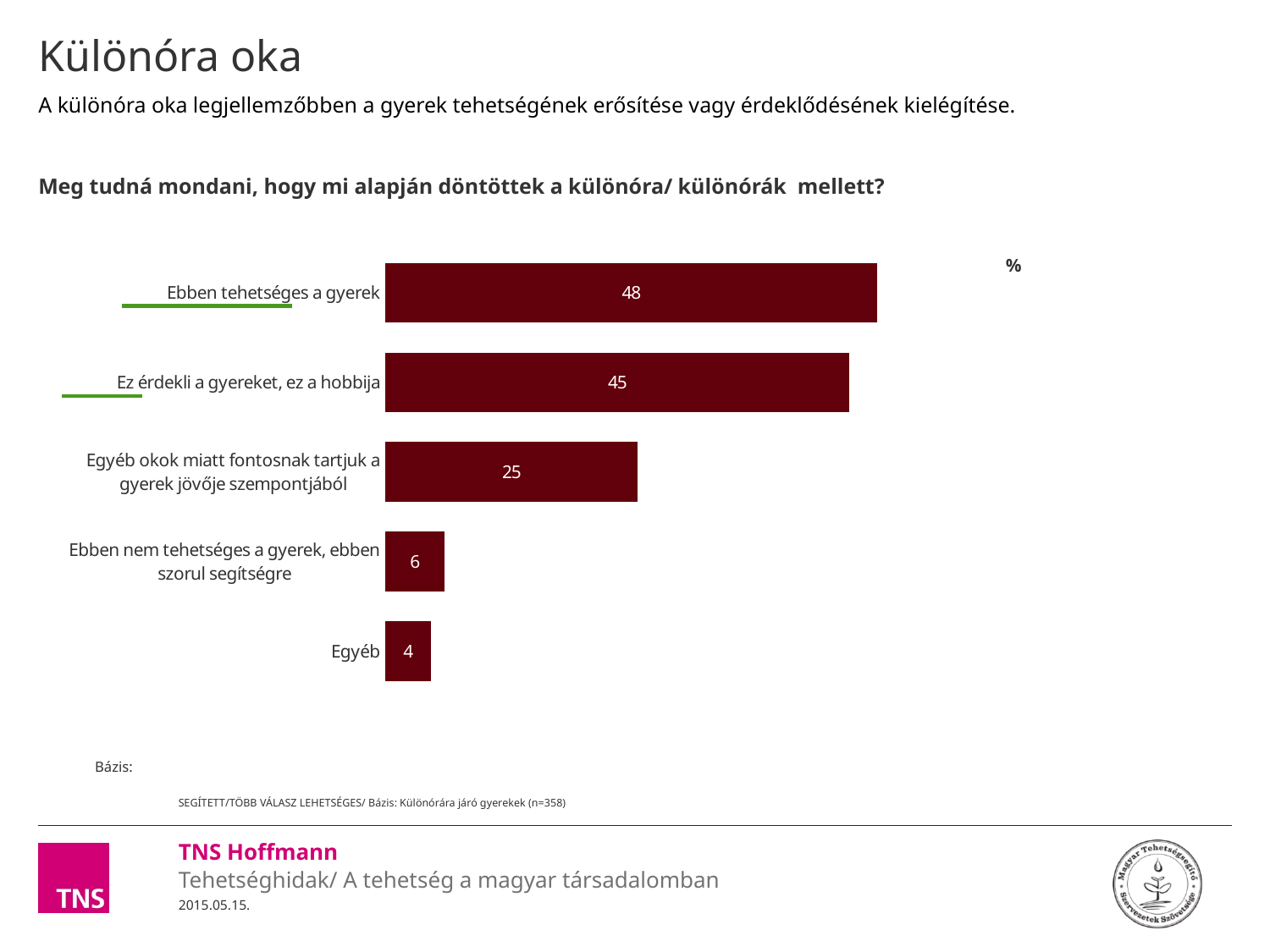
Which category has the highest value? Ebben tehetséges a gyerek What kind of chart is shown on the slide? Bar chart What is the difference between the values for "Ez érdekli a gyereket, ez a hobbija" and "Egyéb okok miatt fontosnak tartjuk a gyerek jövője szempontjából"? 20 Which category has the lowest value? Egyéb What is the value for "Egyéb"? 4 What is the value for "Ebben tehetséges a gyerek"? 48 What is the value for "Ez érdekli a gyereket, ez a hobbija"? 45 How many categories are shown in the chart? 5 What is the value for "Ebben nem tehetséges a gyerek, ebben szorul segítségre"? 6 What is the difference between the values for "Ebben tehetséges a gyerek" and "Ez érdekli a gyereket, ez a hobbija"? 3 Which is larger: the value for "Egyéb okok miatt fontosnak tartjuk a gyerek jövője szempontjából" or the value for "Ebben nem tehetséges a gyerek, ebben szorul segítségre"? Egyéb okok miatt fontosnak tartjuk a gyerek jövője szempontjából What is the value for "Egyéb okok miatt fontosnak tartjuk a gyerek jövője szempontjából"? 25